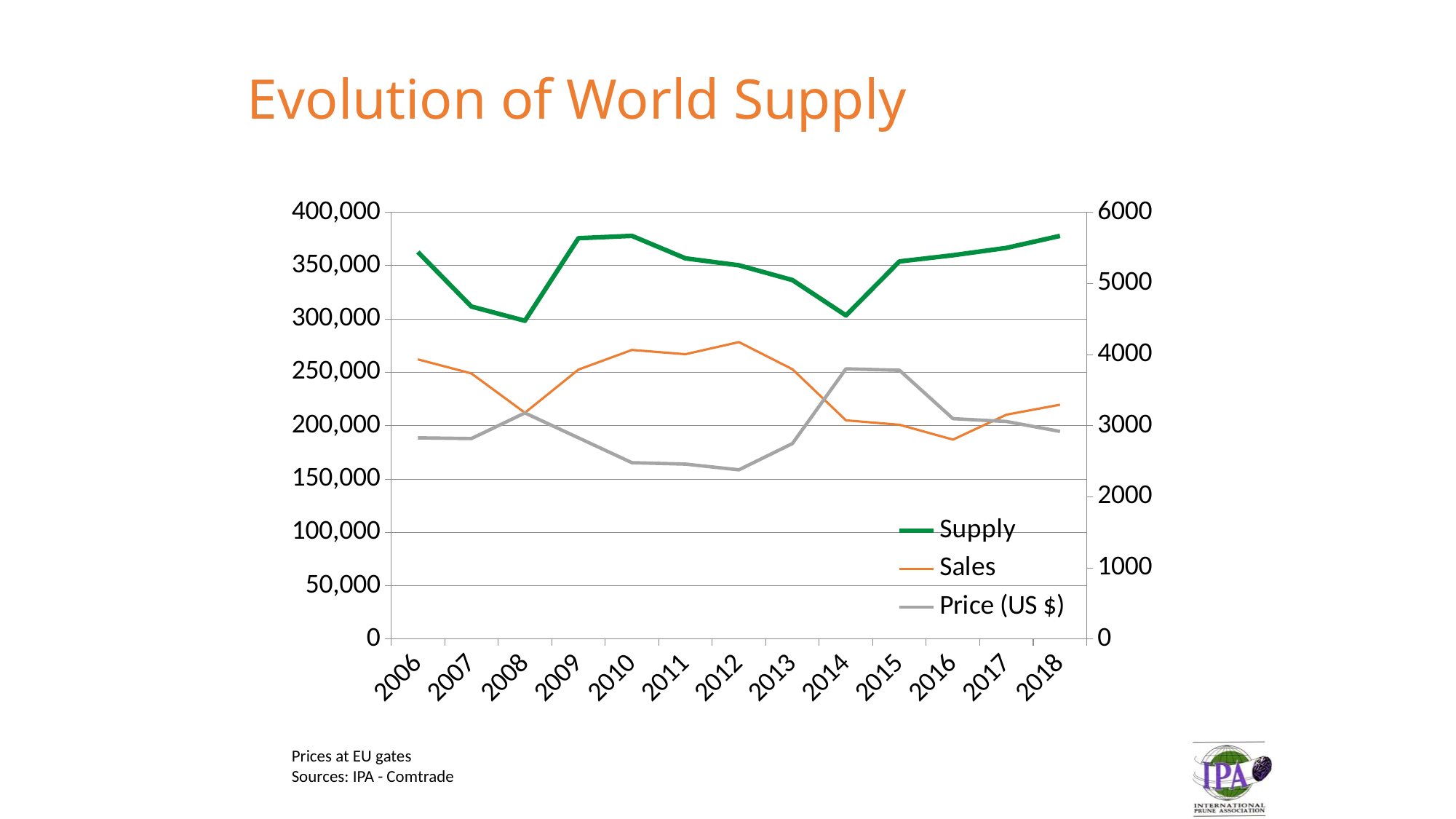
How many years are plotted along the x axis? 13 What is the title of the slide? Evolution of World Supply How many series does the legend list? 3 Is the Price (US $) value for 2014 greater or less than 3000? greater In which year is the Sales series at its lowest? 2016 Which year has the larger Supply value, 2008 or 2009? 2009 Does the Supply series rise or fall from 2014 to 2018? rise Does the Price (US $) series rise or fall from 2015 to 2018? fall Is the Supply value for 2009 greater or less than 350,000? greater What kind of chart is shown on the slide? line chart Is the Sales value for 2016 greater or less than 200,000? less